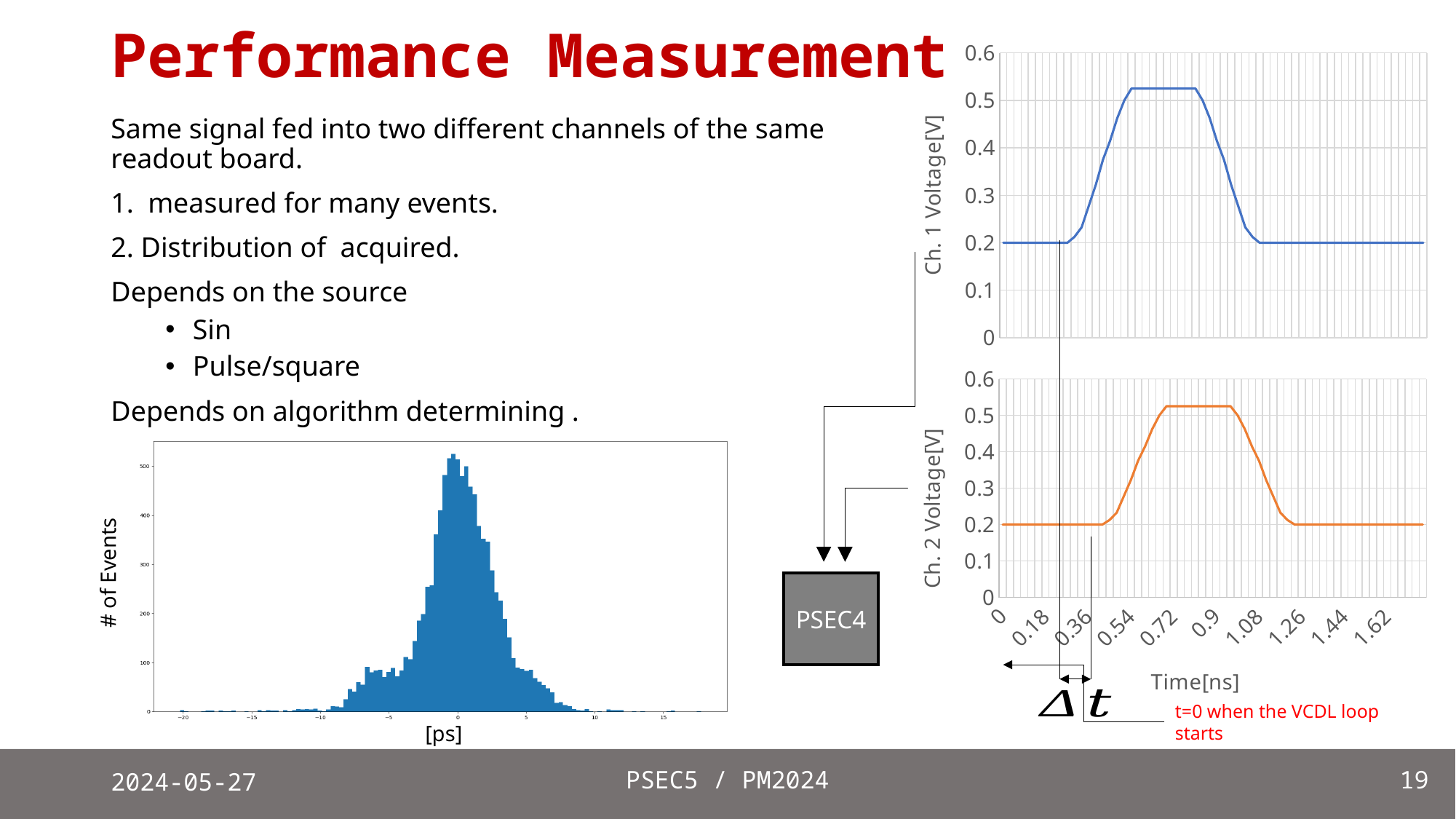
How many tick labels are shown on the Time[ns] x axis of the voltage charts? 10 What colour is the line on the Ch. 2 Voltage[V] chart? orange On the bottom-left histogram, is the tallest bar greater or less than 400 events? greater Comparing the Ch. 1 and Ch. 2 voltage charts, which channel's pulse starts rising earlier in time? Ch. 1 On the Ch. 2 Voltage[V] chart, is the voltage at time 0 greater or less than 0.3? less What kind of chart is the Ch. 1 Voltage[V] chart on the right? line chart On the Ch. 2 Voltage[V] chart, what is the voltage of the flat baseline after the pulse falls? 0.2 On the Ch. 1 Voltage[V] chart, what is the voltage of the flat baseline before the pulse rises? 0.2 What kind of chart is the bottom-left chart with the [ps] x axis? bar chart On the Ch. 1 Voltage[V] chart, is the peak voltage of the pulse greater or less than 0.4? greater On the bottom-left histogram, do the bar heights rise or fall as the x axis goes from -10 ps to 0 ps? rise What is the x-axis label of the bottom-left histogram? [ps]